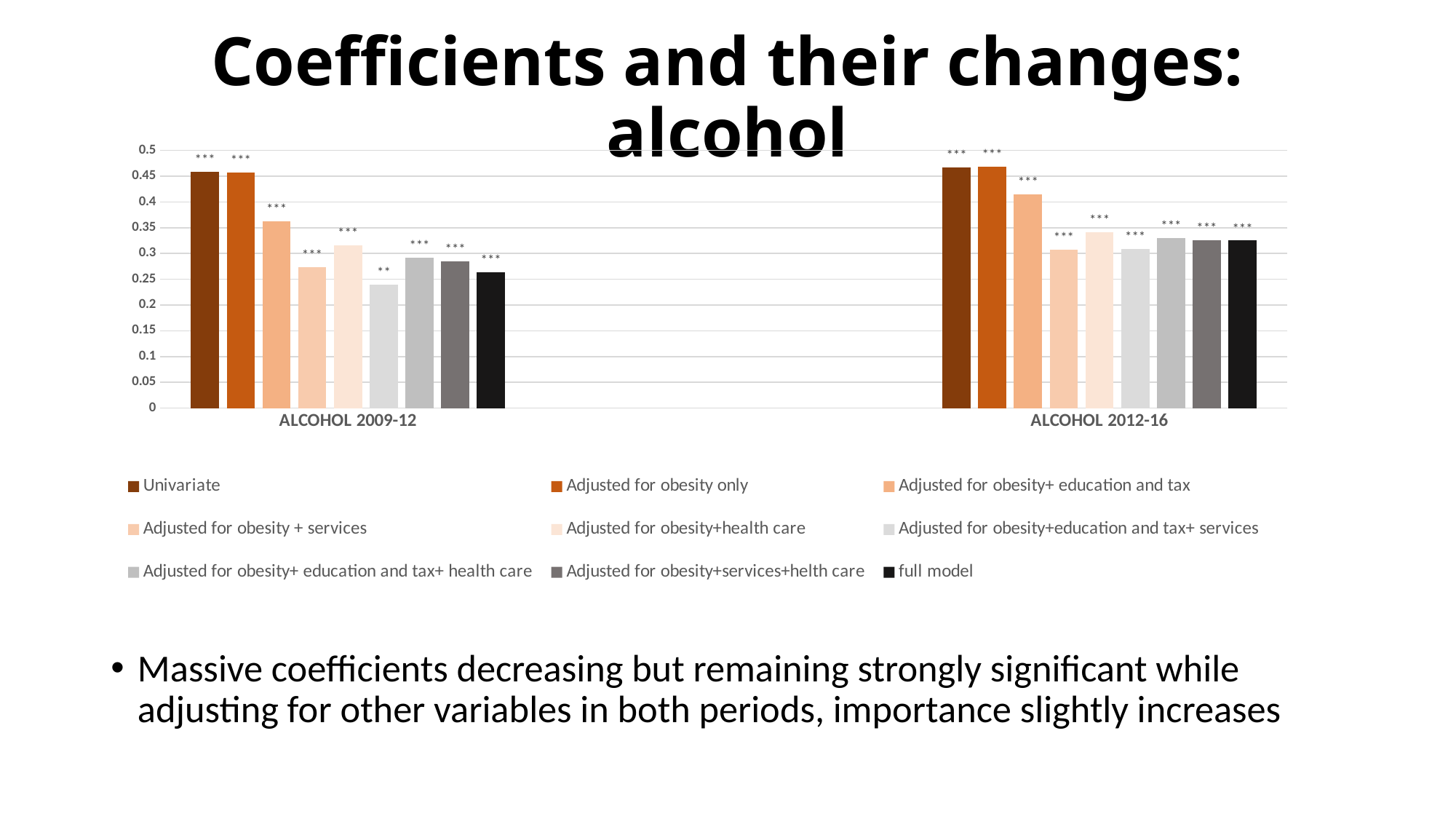
Is the 'Adjusted for obesity+ education and tax' value for ALCOHOL 2012-16 greater or less than 0.4? greater Is the Univariate value for ALCOHOL 2009-12 greater or less than 0.4? greater How many categories are shown on the x axis of the chart? 2 What colour represents the full model series in the chart? Black How many series does the chart's legend list? 9 Is the 'Adjusted for obesity + services' value for ALCOHOL 2009-12 greater or less than 0.3? less Is the full model value larger for ALCOHOL 2009-12 or for ALCOHOL 2012-16? ALCOHOL 2012-16 Which series has the lowest value for ALCOHOL 2009-12? Adjusted for obesity+education and tax+ services What kind of chart is shown on the slide? Bar chart For ALCOHOL 2009-12, which is larger: the Univariate value or the full model value? Univariate